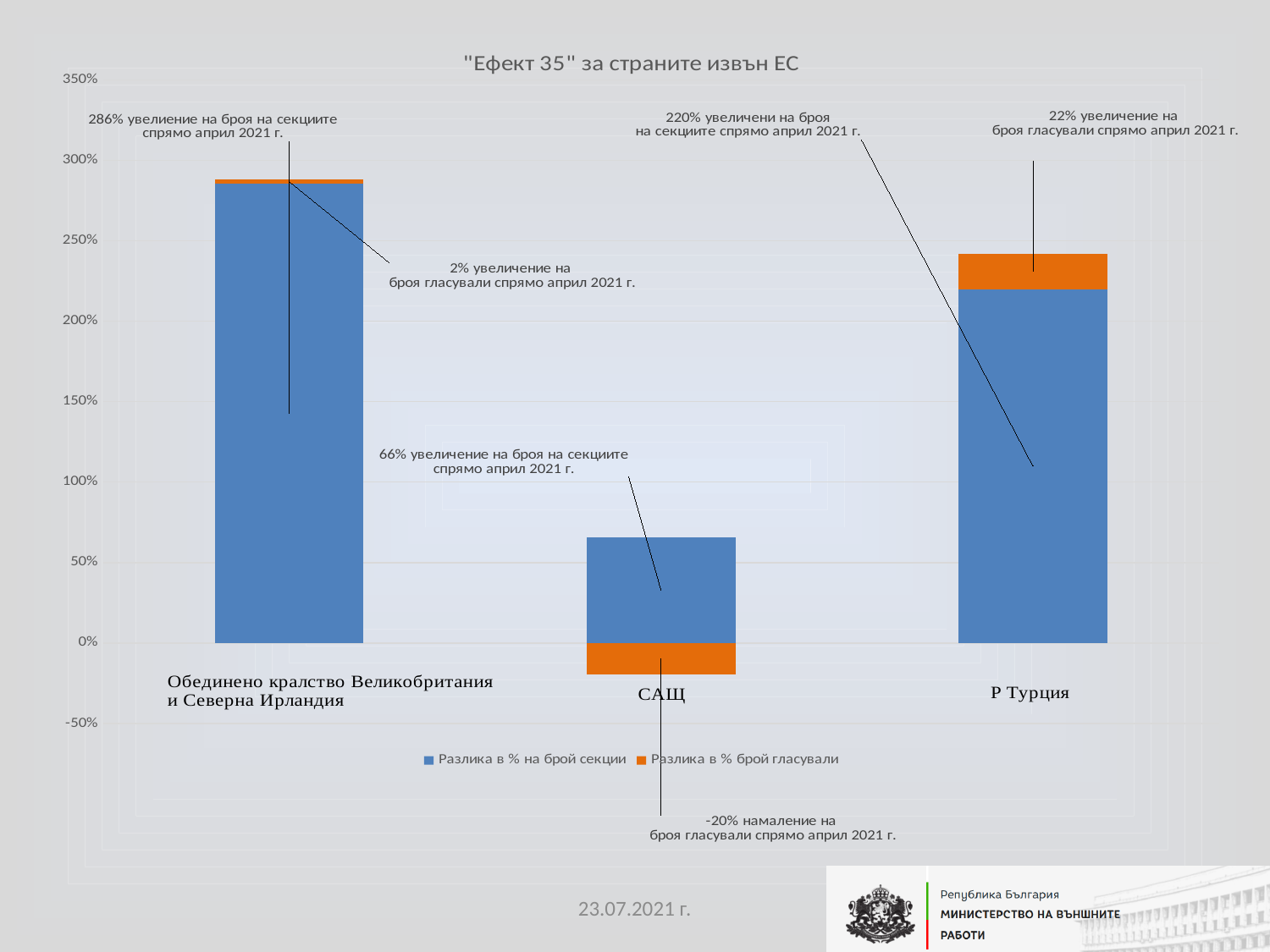
Is the polling-section increase for САЩ greater or less than 100%? less What is the percentage increase in the number of voters for Р Турция? 22% What kind of chart is shown on the slide? stacked bar chart What is the difference between the polling-section increase for Р Турция and for САЩ? 154% What is the percentage increase in the number of polling sections for Р Турция? 220% What is the title of the chart? "Ефект 35" за страните извън ЕС How many series does the legend list? 2 What is the percentage increase in the number of polling sections (Разлика в % на брой секции) for Обединено кралство Великобритания и Северна Ирландия? 286% What is the percentage change in the number of voters (Разлика в % брой гласували) for САЩ? -20% Which country has the highest increase in the number of polling sections? Обединено кралство Великобритания и Северна Ирландия How many countries (categories) are shown on the x axis? 3 Which country has the lowest value for the change in the number of voters? САЩ